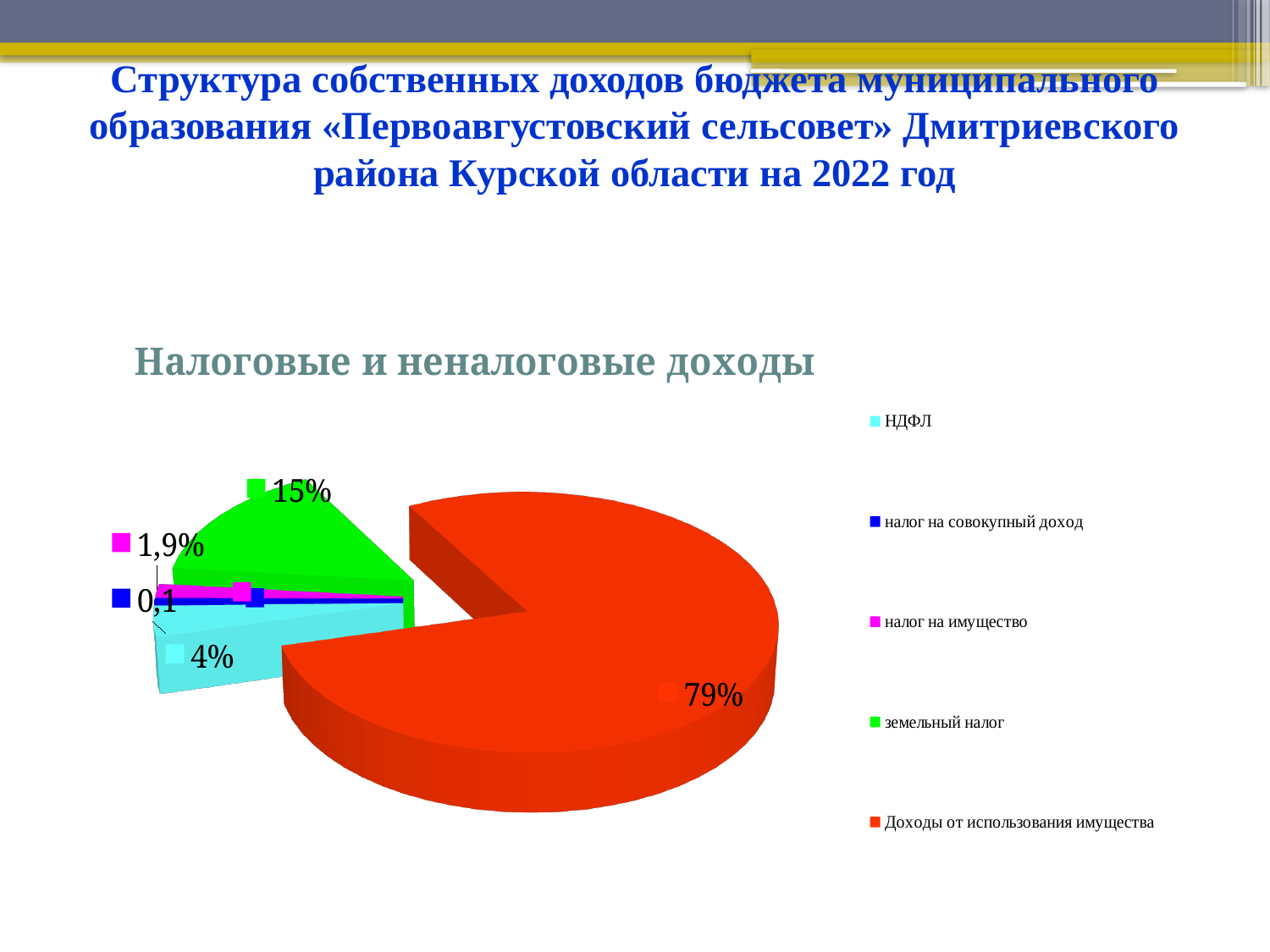
What share of the pie is labelled for НДФЛ? 4% Which category has the smallest slice of the pie? налог на совокупный доход What is the title of the chart? Налоговые и неналоговые доходы What share of the pie is labelled for земельный налог? 15% Which is larger, the slice for земельный налог or the slice for НДФЛ? земельный налог What value is labelled for налог на совокупный доход? 0,1 Which category has the largest slice of the pie? Доходы от использования имущества How many slices does the pie chart have? 5 What value is labelled for налог на имущество? 1,9% What share of the pie is labelled for Доходы от использования имущества? 79% What is the difference in percentage points between the Доходы от использования имущества slice and the земельный налог slice? 64 What kind of chart is shown on the slide? pie chart